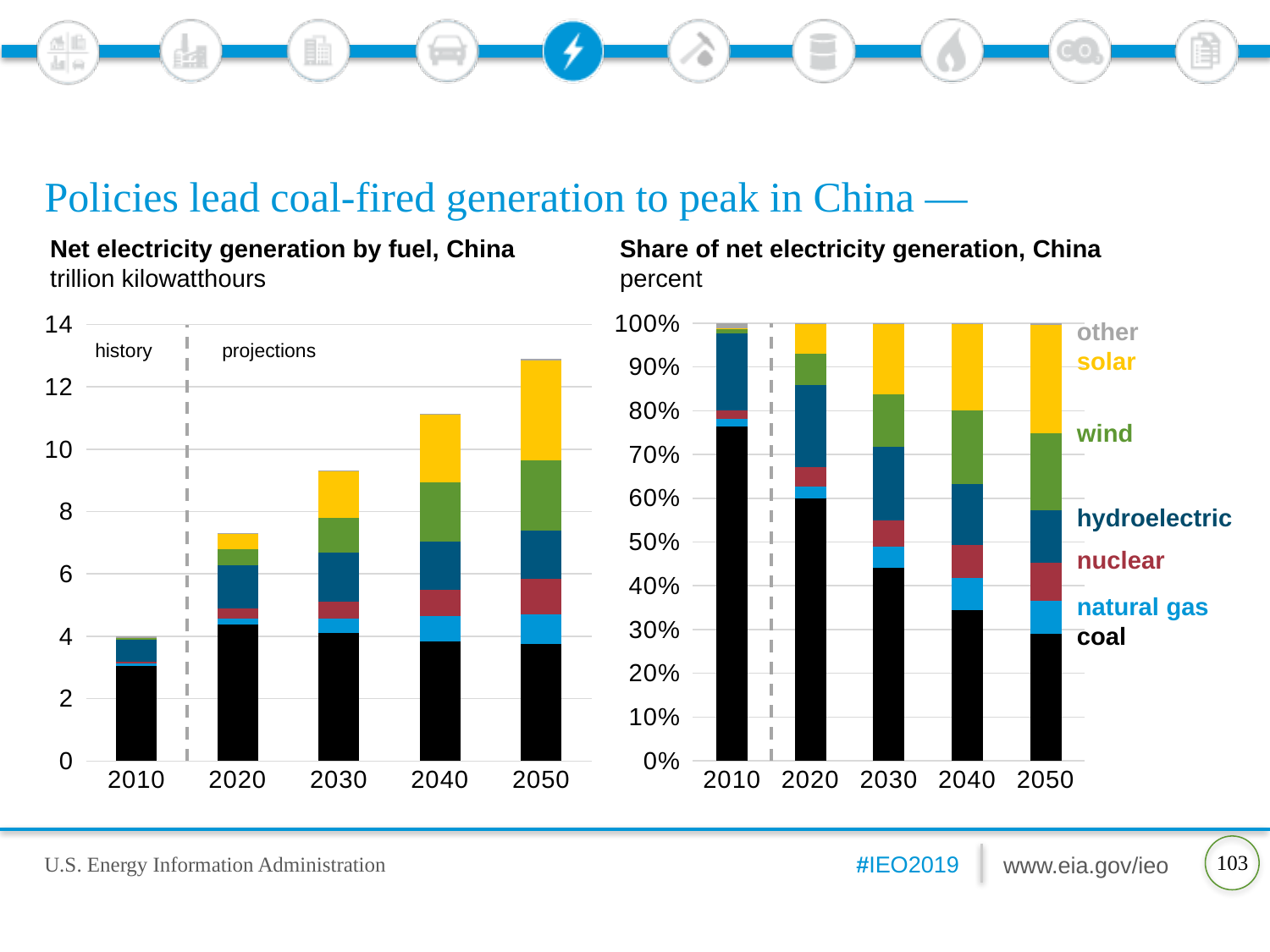
What unit is given under the title of the left chart, 'Net electricity generation by fuel, China'? trillion kilowatthours In the left chart, 'Net electricity generation by fuel, China', which year has the lowest total net electricity generation? 2010 In the right chart, 'Share of net electricity generation, China', does the coal share rise or fall from 2010 to 2050? fall In the left chart, 'Net electricity generation by fuel, China', is the total generation in 2050 greater or less than 12 trillion kilowatthours? greater In the right chart, 'Share of net electricity generation, China', is the coal share in 2050 greater or less than 40%? less In the left chart, 'Net electricity generation by fuel, China', which year has the highest total net electricity generation? 2050 How many fuel series does the legend of the right chart, 'Share of net electricity generation, China', list? 7 In the left chart, 'Net electricity generation by fuel, China', is the total generation in 2010 greater or less than 6 trillion kilowatthours? less What kind of chart is the left chart, 'Net electricity generation by fuel, China'? stacked bar chart In the left chart, 'Net electricity generation by fuel, China', does total net electricity generation rise or fall from 2010 to 2050? rise How many years are shown on the x axis of the left chart, 'Net electricity generation by fuel, China'? 5